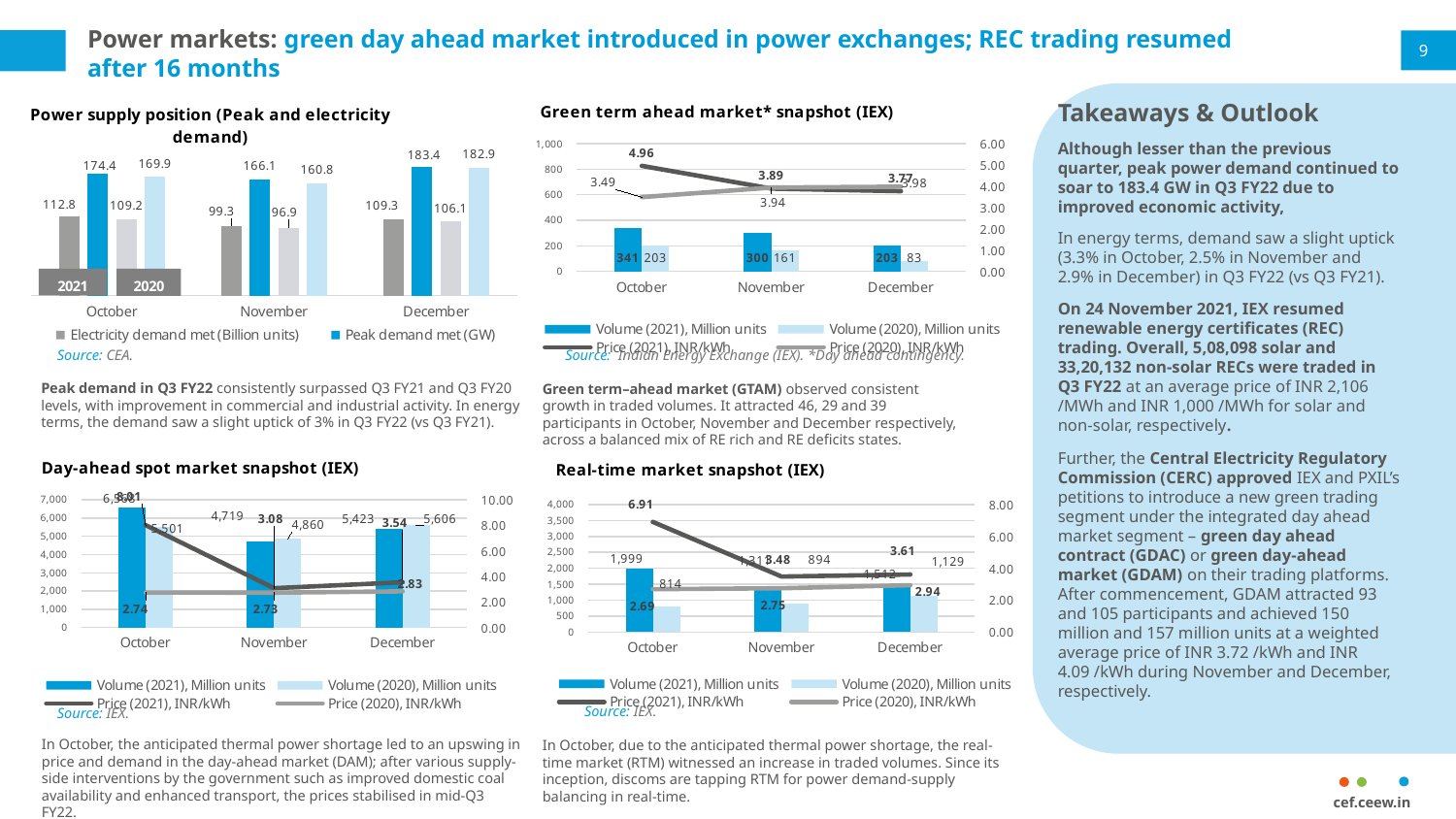
In the 'Green term ahead market snapshot (IEX)' chart, which month has the lowest volume (2020)? December In the 'Real-time market snapshot (IEX)' chart, what was the price (2020) in December, in INR/kWh? 2.94 In the 'Green term ahead market snapshot (IEX)' chart, what was the price (2021) in November, in INR/kWh? 3.89 In the 'Power supply position' chart, what is the difference between peak demand met (GW) in October 2021 and October 2020? 4.5 In the 'Power supply position' chart, what was the peak demand met (GW) in December 2021? 183.4 In the 'Green term ahead market snapshot (IEX)' chart, does the volume (2021) rise or fall from October to December? fall In the 'Day-ahead spot market snapshot (IEX)' chart, what was the volume (2020) in December, in million units? 5,606 In the 'Day-ahead spot market snapshot (IEX)' chart, what was the price (2021) in October, in INR/kWh? 8.01 How many series does the legend of the 'Real-time market snapshot (IEX)' chart list? 4 In the 'Power supply position' chart, what was the electricity demand met (Billion units) in November 2020? 96.9 In the 'Green term ahead market snapshot (IEX)' chart, what was the volume (2021) in October, in million units? 341 In the 'Power supply position' chart, which month has the highest peak demand met (GW) for 2021? December